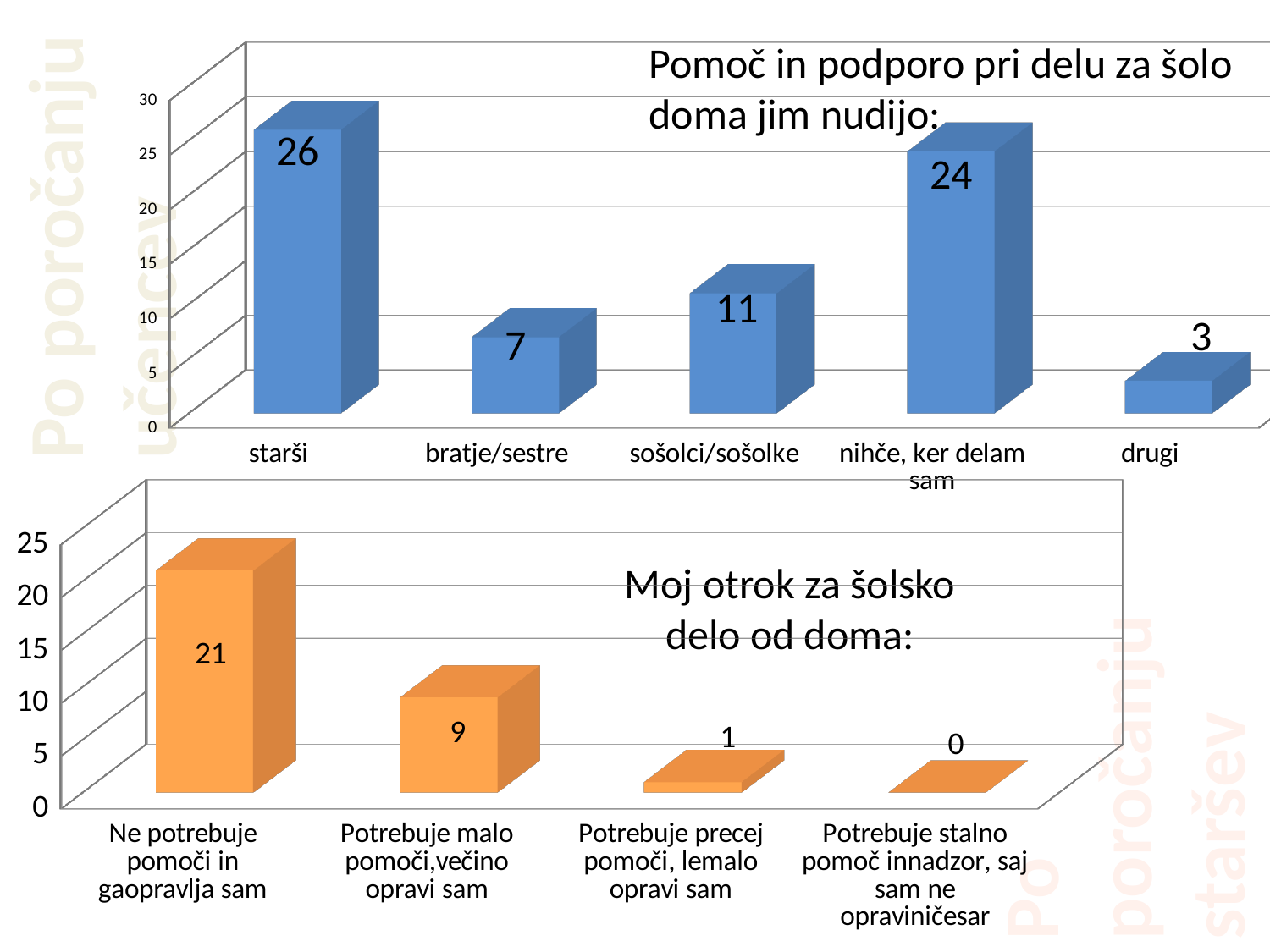
In the bottom chart 'Moj otrok za šolsko delo od doma:', do the values rise or fall from left to right? fall What type of chart is the bottom chart 'Moj otrok za šolsko delo od doma:'? bar chart In the bottom chart 'Moj otrok za šolsko delo od doma:', what is the value for 'Potrebuje malo pomoči,večino opravi sam'? 9 In the bottom chart 'Moj otrok za šolsko delo od doma:', which category has the highest value? Ne potrebuje pomoči in gaopravlja sam In the top chart 'Pomoč in podporo pri delu za šolo doma jim nudijo:', which category has the lowest value? drugi In the top chart 'Pomoč in podporo pri delu za šolo doma jim nudijo:', which category has the highest value? starši In the top chart 'Pomoč in podporo pri delu za šolo doma jim nudijo:', how many categories are shown? 5 In the top chart 'Pomoč in podporo pri delu za šolo doma jim nudijo:', what is the value for 'starši'? 26 In the top chart 'Pomoč in podporo pri delu za šolo doma jim nudijo:', what is the value for 'sošolci/sošolke'? 11 In the bottom chart 'Moj otrok za šolsko delo od doma:', what is the difference between the first category (21) and the second category (9)? 12 In the top chart 'Pomoč in podporo pri delu za šolo doma jim nudijo:', what is the difference between 'starši' and 'nihče, ker delam sam'? 2 In the bottom chart 'Moj otrok za šolsko delo od doma:', what is the value for 'Potrebuje stalno pomoč innadzor, saj sam ne opraviničesar'? 0